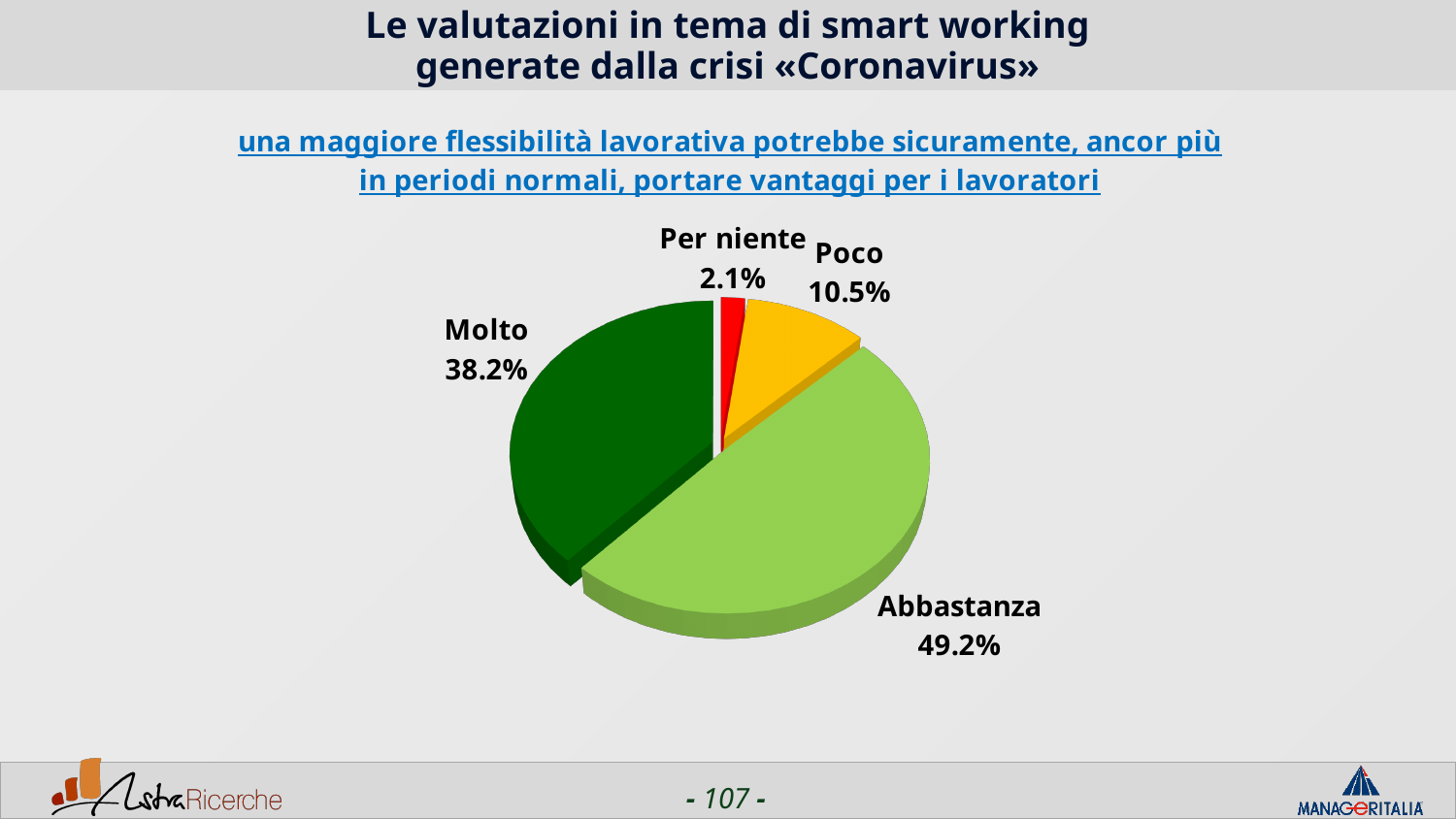
Which category has the largest share of the pie? Abbastanza What colour is the Per niente slice? red What is the value for Molto? 38.2% How many categories are shown in the pie chart? 4 Which category has the smallest share of the pie? Per niente What is the difference between the values for Poco and Per niente? 8.4% Which is larger, the value for Molto or the value for Poco? Molto What kind of chart is shown on the slide? pie chart What is the value for Abbastanza? 49.2% What is the value for Poco? 10.5% What is the value for Per niente? 2.1% What is the difference between the values for Abbastanza and Molto? 11.0%